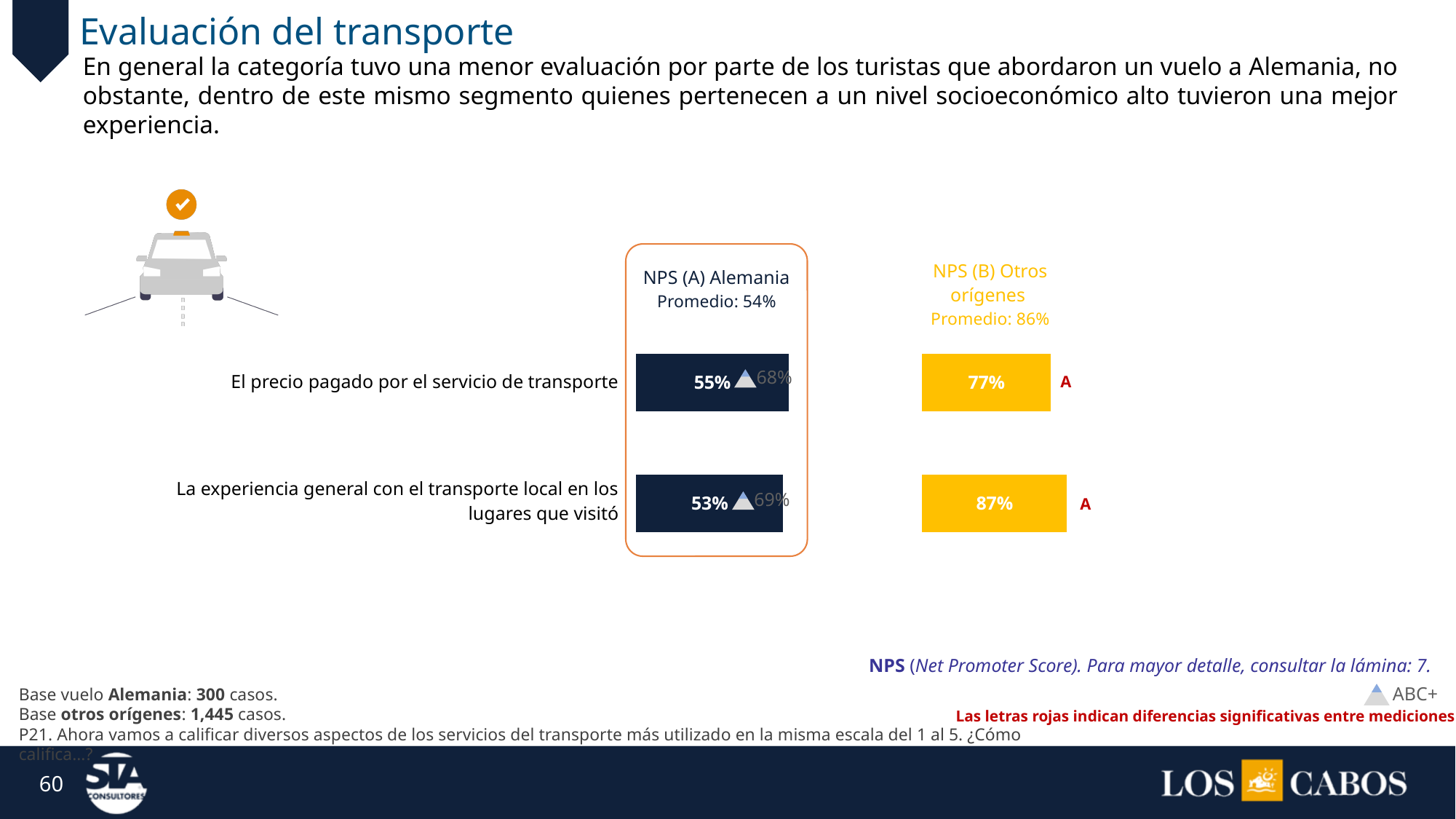
In the NPS (B) Otros orígenes chart, which category has the highest value? La experiencia general con el transporte local en los lugares que visitó For 'La experiencia general con el transporte local en los lugares que visitó', which is larger: the NPS (A) Alemania value or the NPS (B) Otros orígenes value? NPS (B) Otros orígenes What is the 'Promedio' shown for NPS (B) Otros orígenes? 86% What type of chart is used to show the NPS values on this slide? Bar chart In the NPS (A) Alemania chart, what is the value for 'La experiencia general con el transporte local en los lugares que visitó'? 53% In the NPS (B) Otros orígenes chart, what is the value for 'La experiencia general con el transporte local en los lugares que visitó'? 87% In the NPS (A) Alemania chart, what is the value for 'El precio pagado por el servicio de transporte'? 55% How many categories are shown in the NPS (A) Alemania chart? 2 What is the difference between the two categories in the NPS (B) Otros orígenes chart? 10 percentage points In the NPS (A) Alemania chart, which category has the lowest value? La experiencia general con el transporte local en los lugares que visitó What is the difference between the NPS (B) Otros orígenes value and the NPS (A) Alemania value for 'El precio pagado por el servicio de transporte'? 22 percentage points In the NPS (B) Otros orígenes chart, what is the value for 'El precio pagado por el servicio de transporte'? 77%